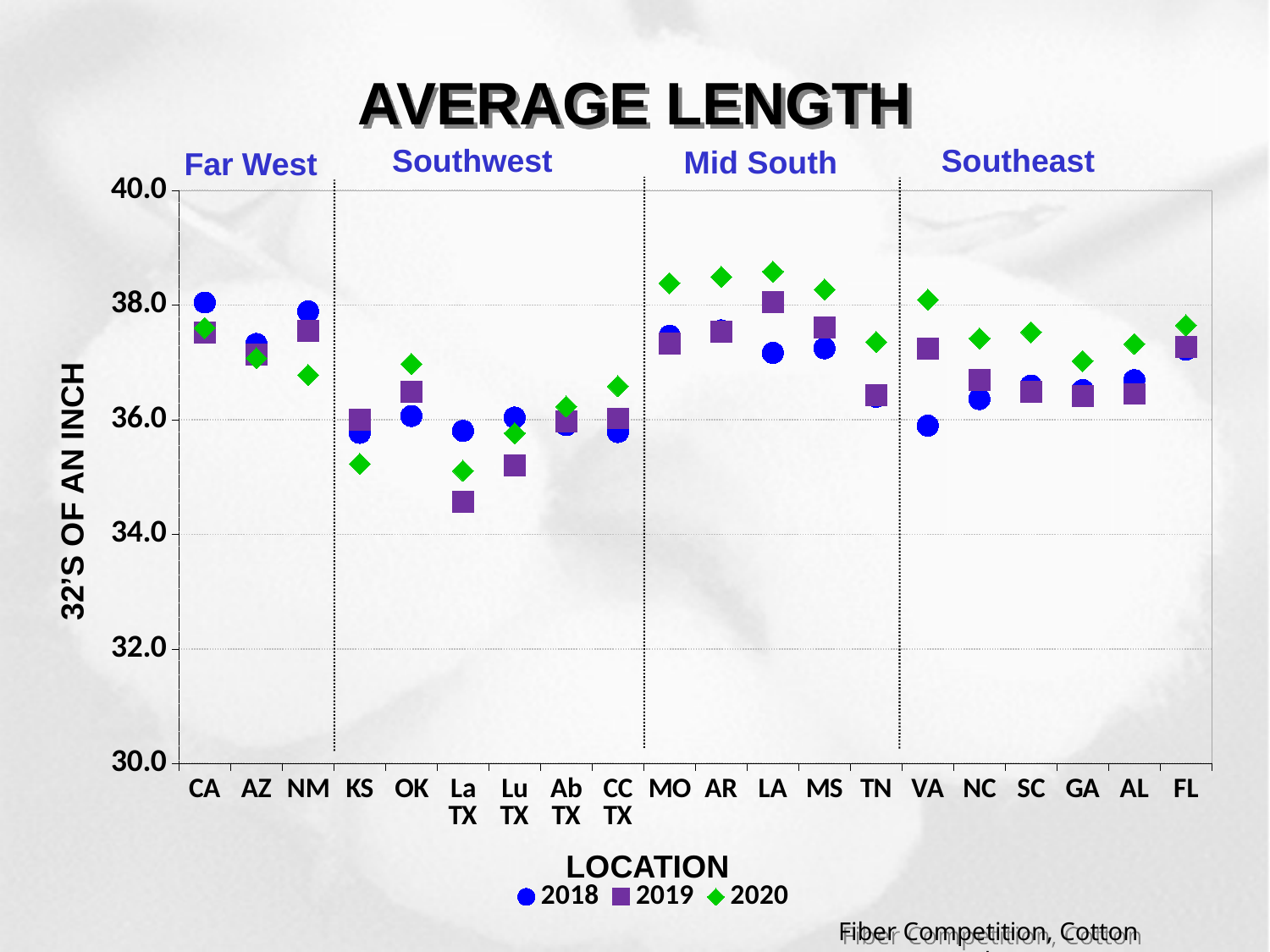
Which location has the highest 2019 value? LA Is the 2020 value for LA greater or less than 38.0? greater What kind of chart is this? scatter chart At MO, which series has the larger value, 2018 or 2020? 2020 What is the label on the y axis? 32'S OF AN INCH Is the 2019 value for La TX greater or less than 35.0? less Is the 2020 value for MO greater or less than 38.0? greater At CA, which series has the larger value, 2018 or 2020? 2018 Which location has the lowest 2019 value? La TX How many series does the legend list? 3 How many locations are plotted along the x axis? 20